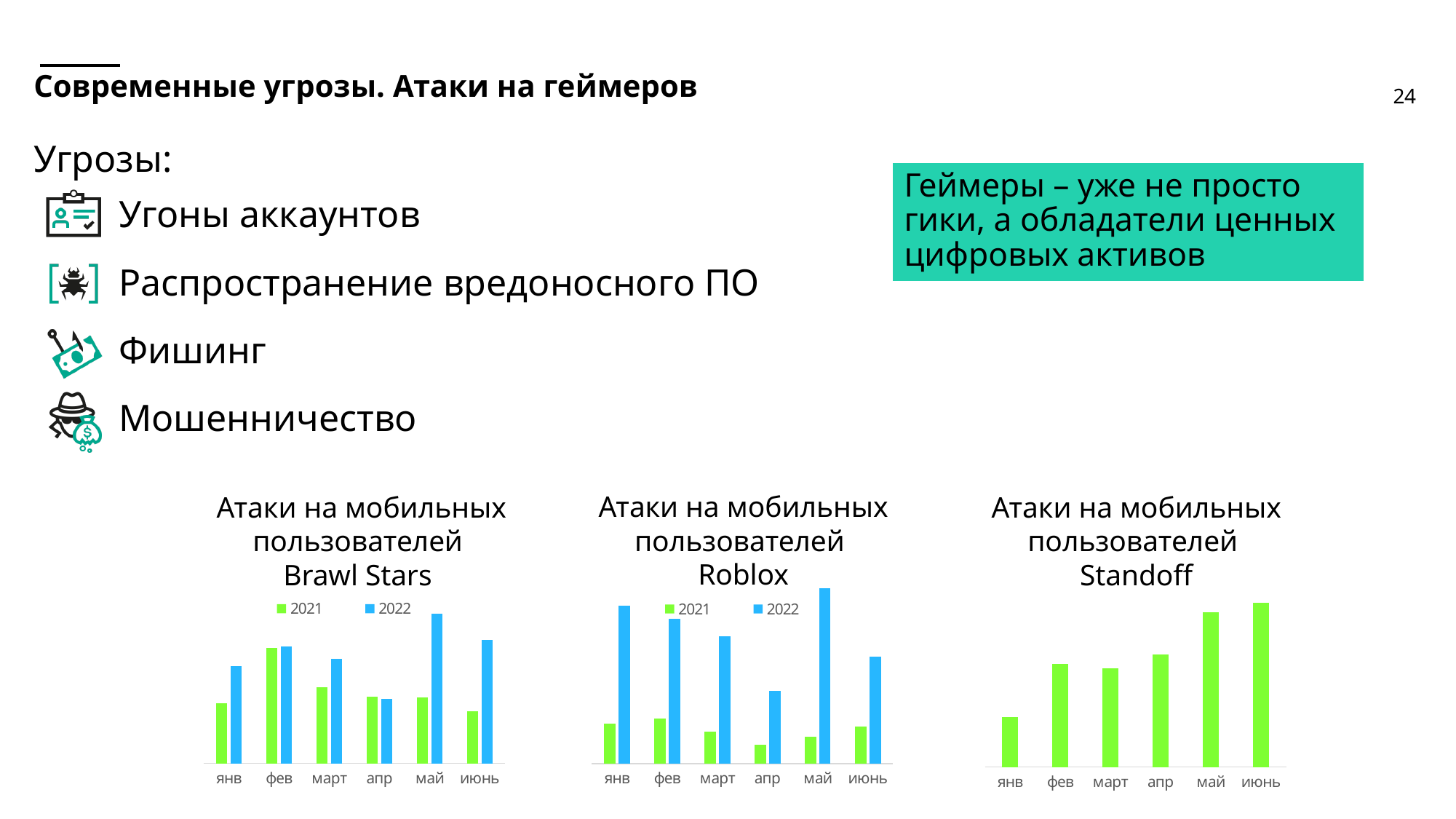
In the "Атаки на мобильных пользователей Standoff" chart, which month has the lowest value? янв What kind of chart is the "Атаки на мобильных пользователей Brawl Stars" chart? bar chart In the "Атаки на мобильных пользователей Brawl Stars" chart, how many series does the legend list? 2 In the "Атаки на мобильных пользователей Roblox" chart, which month has the highest value for 2022? май How many months are shown on the x axis of the "Атаки на мобильных пользователей Roblox" chart? 6 In the "Атаки на мобильных пользователей Brawl Stars" chart, which is larger in май: 2021 or 2022? 2022 In the "Атаки на мобильных пользователей Standoff" chart, which month has the highest value? июнь In the "Атаки на мобильных пользователей Brawl Stars" chart, which month has the lowest value for 2022? апр In the "Атаки на мобильных пользователей Brawl Stars" chart, which month has the highest value for 2021? фев In the "Атаки на мобильных пользователей Roblox" chart, which month has the lowest value for 2022? апр In the "Атаки на мобильных пользователей Roblox" chart, which is larger in янв: 2021 or 2022? 2022